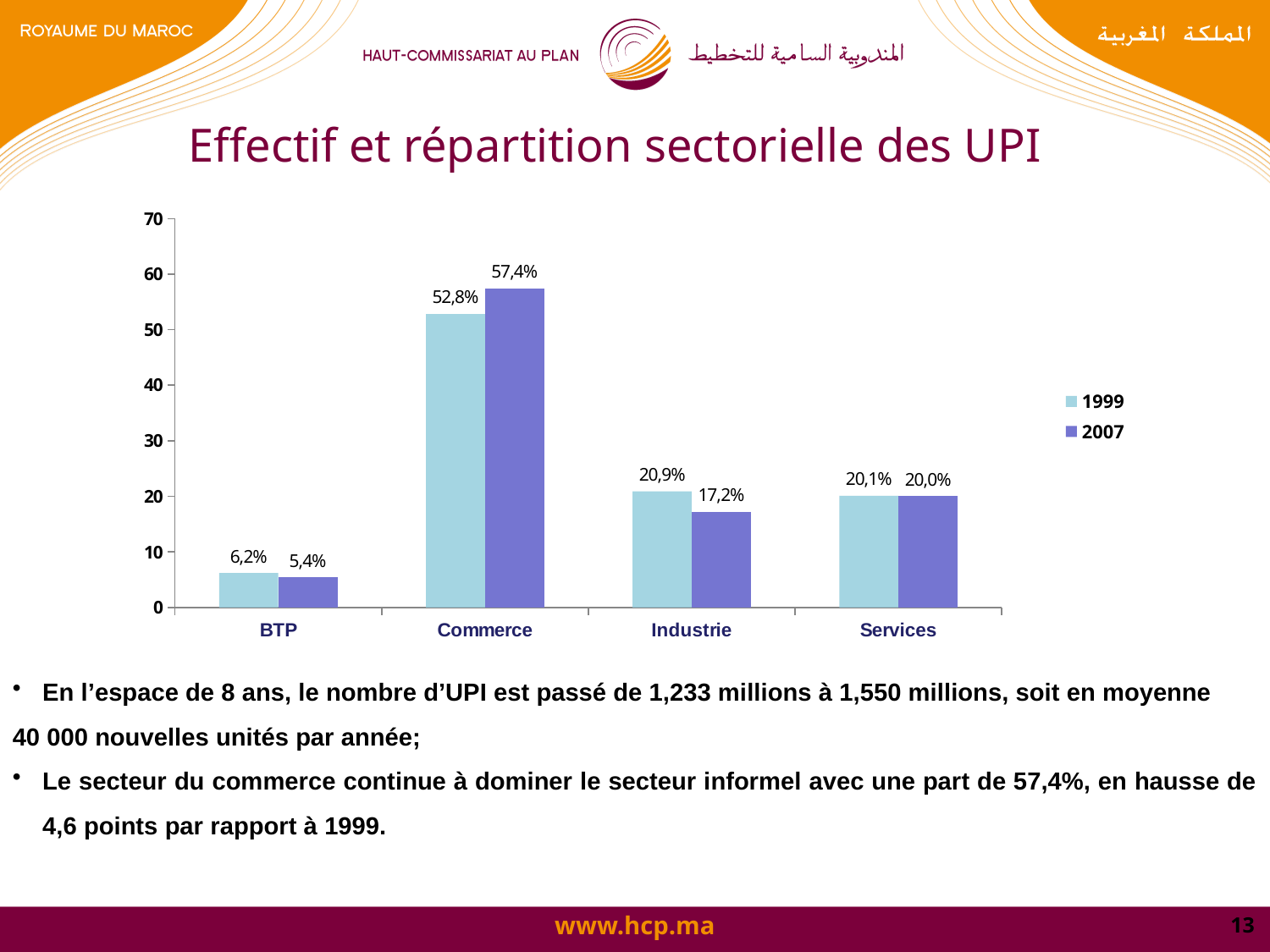
What is the value for BTP in 1999? 6,2% How many series does the legend list? 2 What is the difference between the 2007 and 1999 values for Commerce? 4,6 points What kind of chart is shown on the slide? Bar chart What is the value for Services in 1999? 20,1% Which category has the lowest value in 2007? BTP How many categories are shown on the x axis? 4 Which category has the highest value in 1999? Commerce What is the value for Commerce in 2007? 57,4% What is the value for Industrie in 2007? 17,2% Which is larger for Industrie: the 1999 value or the 2007 value? 1999 Is the value for Commerce in 1999 greater or less than 50? greater